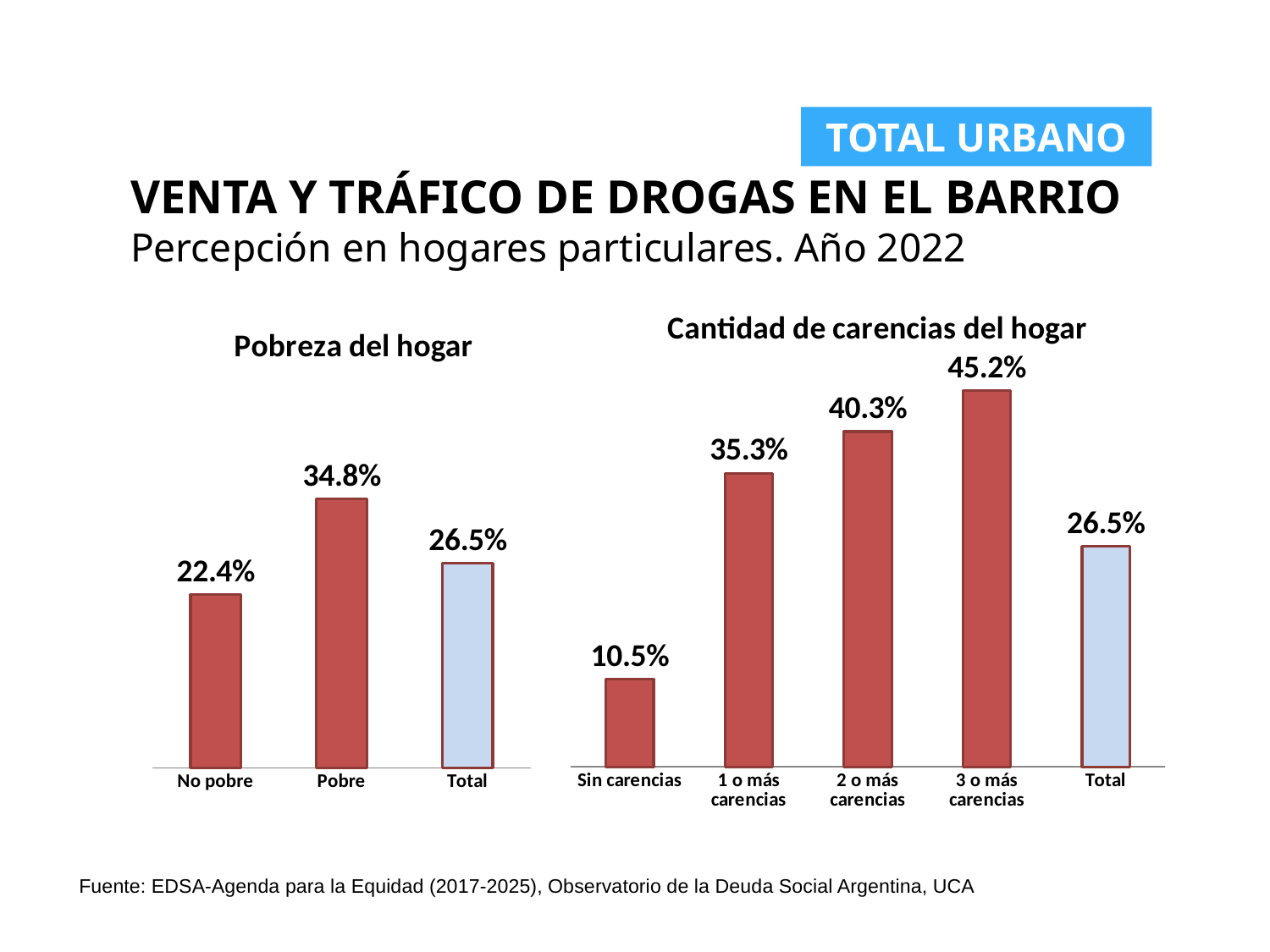
In the 'Cantidad de carencias del hogar' chart, what is the value for 'Sin carencias'? 10.5% In the 'Cantidad de carencias del hogar' chart, which is larger: '1 o más carencias' or '2 o más carencias'? 2 o más carencias In the 'Pobreza del hogar' chart, what is the difference between 'Pobre' and 'No pobre'? 12.4% In the 'Cantidad de carencias del hogar' chart, what is the difference between '3 o más carencias' and 'Sin carencias'? 34.7% How many categories are shown in the 'Cantidad de carencias del hogar' chart? 5 In the 'Cantidad de carencias del hogar' chart, which category has the lowest value? Sin carencias In the 'Pobreza del hogar' chart, what is the value for 'No pobre'? 22.4% In the 'Pobreza del hogar' chart, which category has the highest value? Pobre What kind of chart is the 'Pobreza del hogar' chart? Bar chart In the 'Pobreza del hogar' chart, what is the value for 'Pobre'? 34.8% In the 'Cantidad de carencias del hogar' chart, what is the value for '3 o más carencias'? 45.2% In the 'Cantidad de carencias del hogar' chart, do the values rise or fall from 'Sin carencias' to '3 o más carencias'? Rise